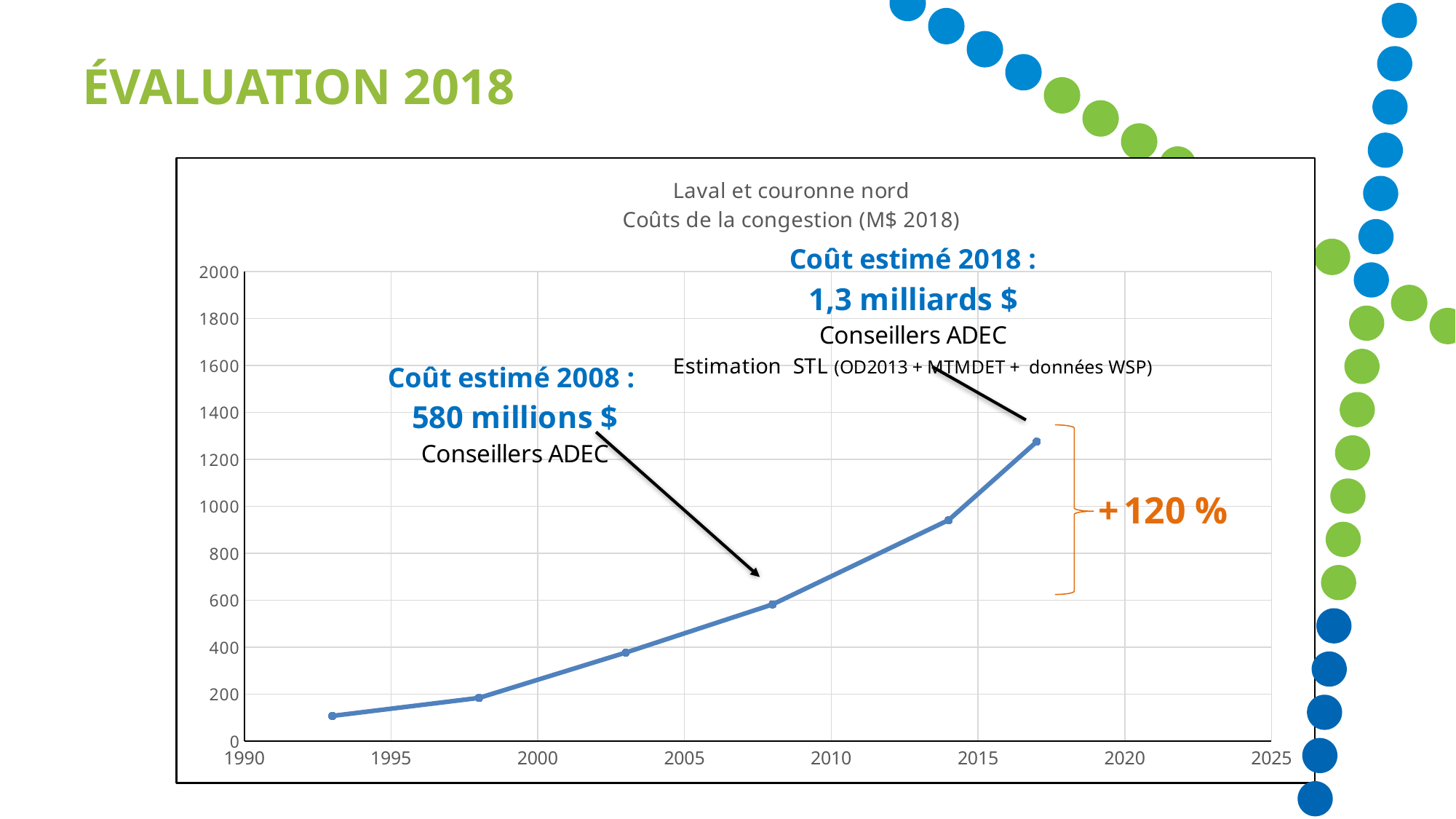
Is the value for 2003 greater or less than 400? less What kind of chart is shown on the slide? line chart Which year has the highest congestion cost on the chart? 2017 Do the congestion costs rise or fall over time along the x axis? rise Is the value for the first data point (around 1993) greater or less than 200? less What is the title of the chart? Laval et couronne nord Coûts de la congestion (M$ 2018) Which is larger, the value for 2008 or the value for 2014? 2014 What percentage increase is indicated by the orange bracket on the chart? +120 % According to the annotation, what is the estimated congestion cost for 2008? 580 millions $ According to the annotation, what is the estimated congestion cost for 2018? 1,3 milliards $ How many data points are plotted on the line? 6 Is the value for 2014 greater or less than 800? greater